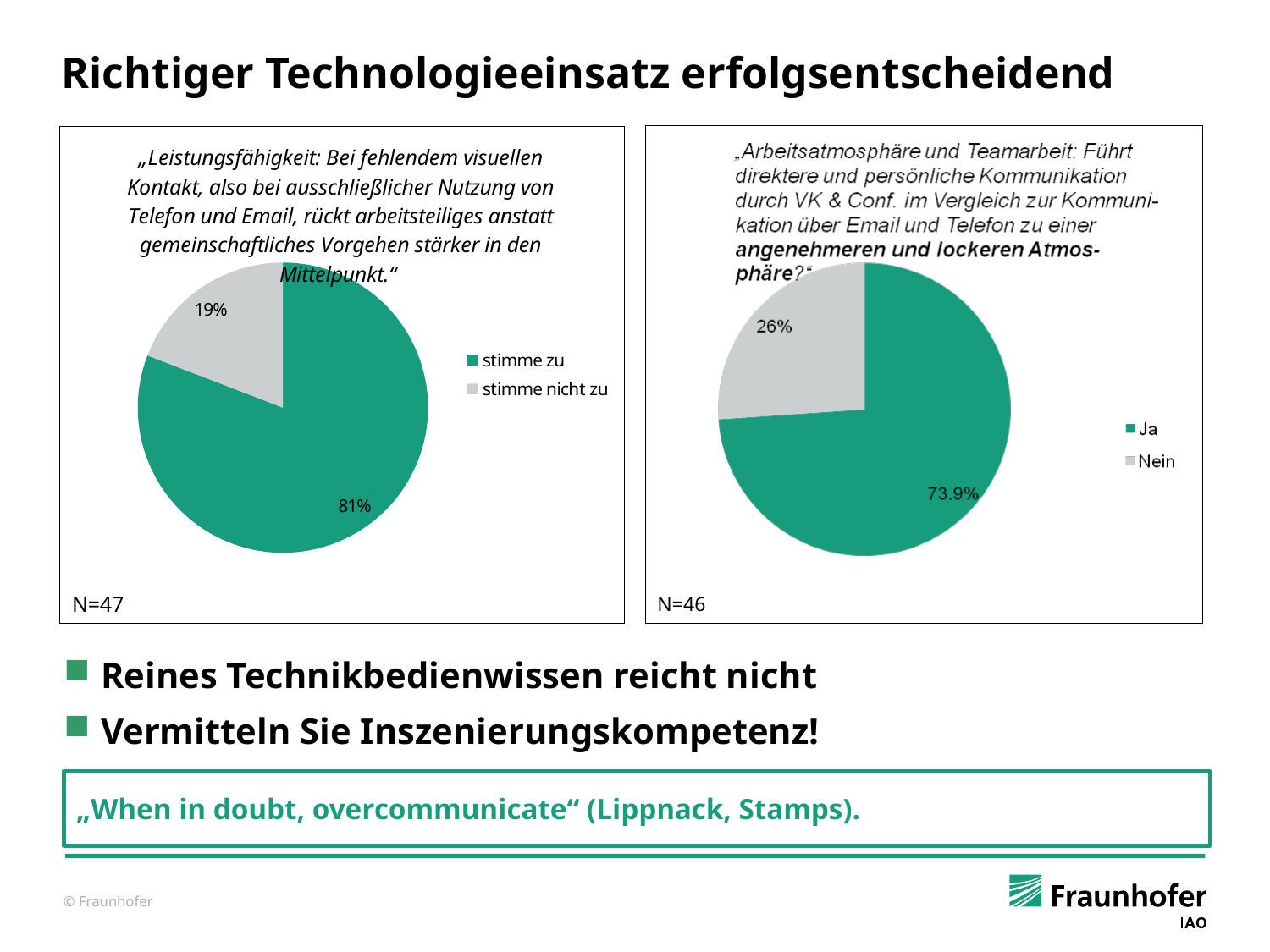
In the right pie chart, what share of respondents answered "Nein"? 26% What type of chart is shown on the left side of the slide? Pie chart In the left pie chart, which category has the largest slice? stimme zu In the right pie chart, what share of respondents answered "Ja"? 73.9% In the left pie chart, what share of respondents answered "stimme zu"? 81% In the right pie chart, which category has the smallest slice? Nein Which is larger: the "stimme zu" share in the left chart or the "Ja" share in the right chart? stimme zu (left chart) How many entries does the legend of the left pie chart list? 2 What sample size (N) is given for the right pie chart? N=46 In the left pie chart, what share of respondents answered "stimme nicht zu"? 19% In the left pie chart, what is the difference in percentage points between "stimme zu" and "stimme nicht zu"? 62 percentage points How many slices does the right pie chart have? 2